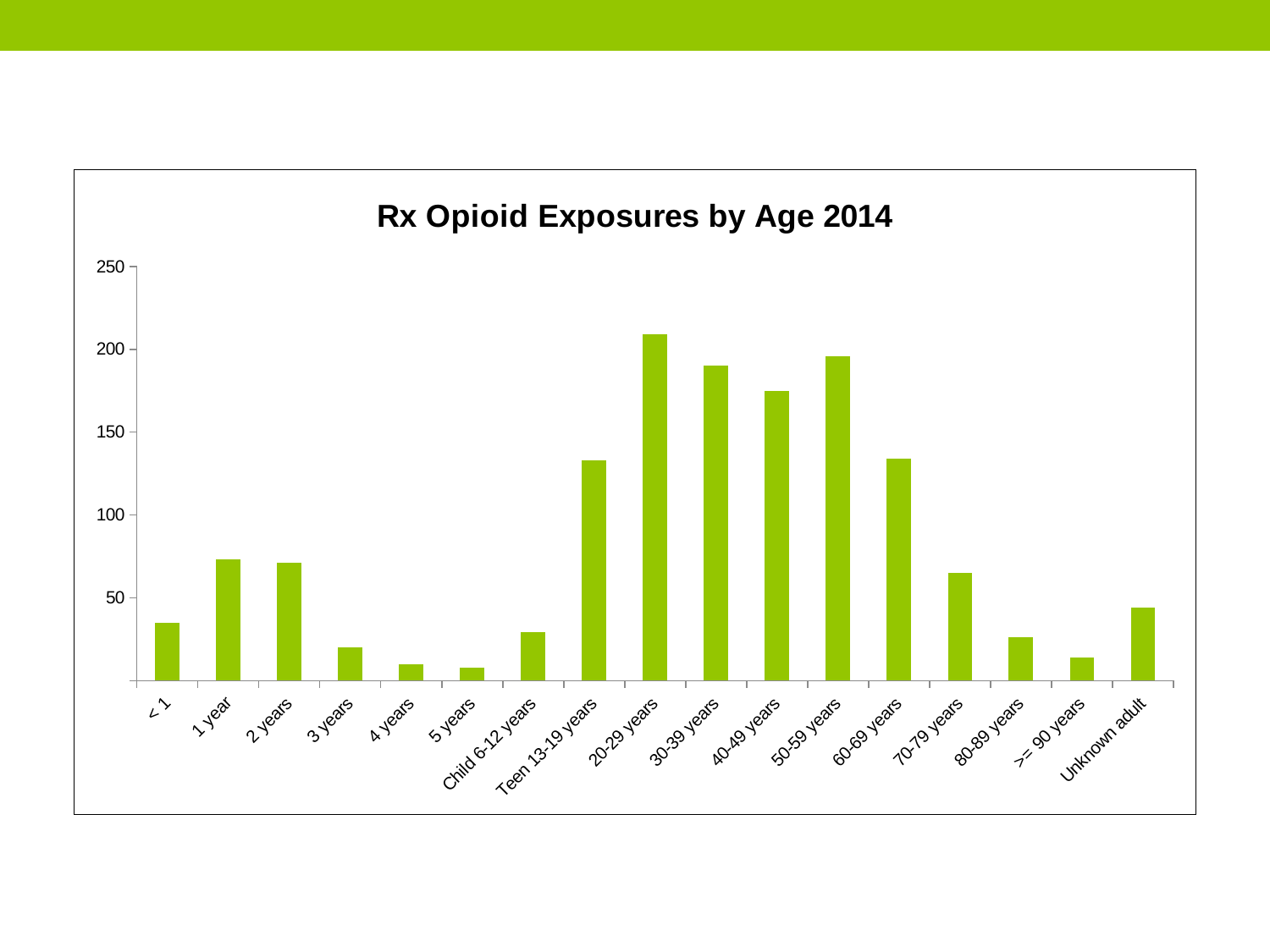
Which is larger, the value for 20-29 years or the value for 50-59 years? 20-29 years Is the value for 60-69 years greater or less than 150? less Which age category has the highest number of Rx opioid exposures? 20-29 years What kind of chart is shown on the slide? bar chart How many age categories are shown on the x axis? 17 Which is larger, the value for 30-39 years or the value for 40-49 years? 30-39 years Do the values rise or fall from 20-29 years to 40-49 years? fall Is the value for 20-29 years greater or less than 200? greater Is the value for 3 years greater or less than 50? less What is the title of the chart? Rx Opioid Exposures by Age 2014